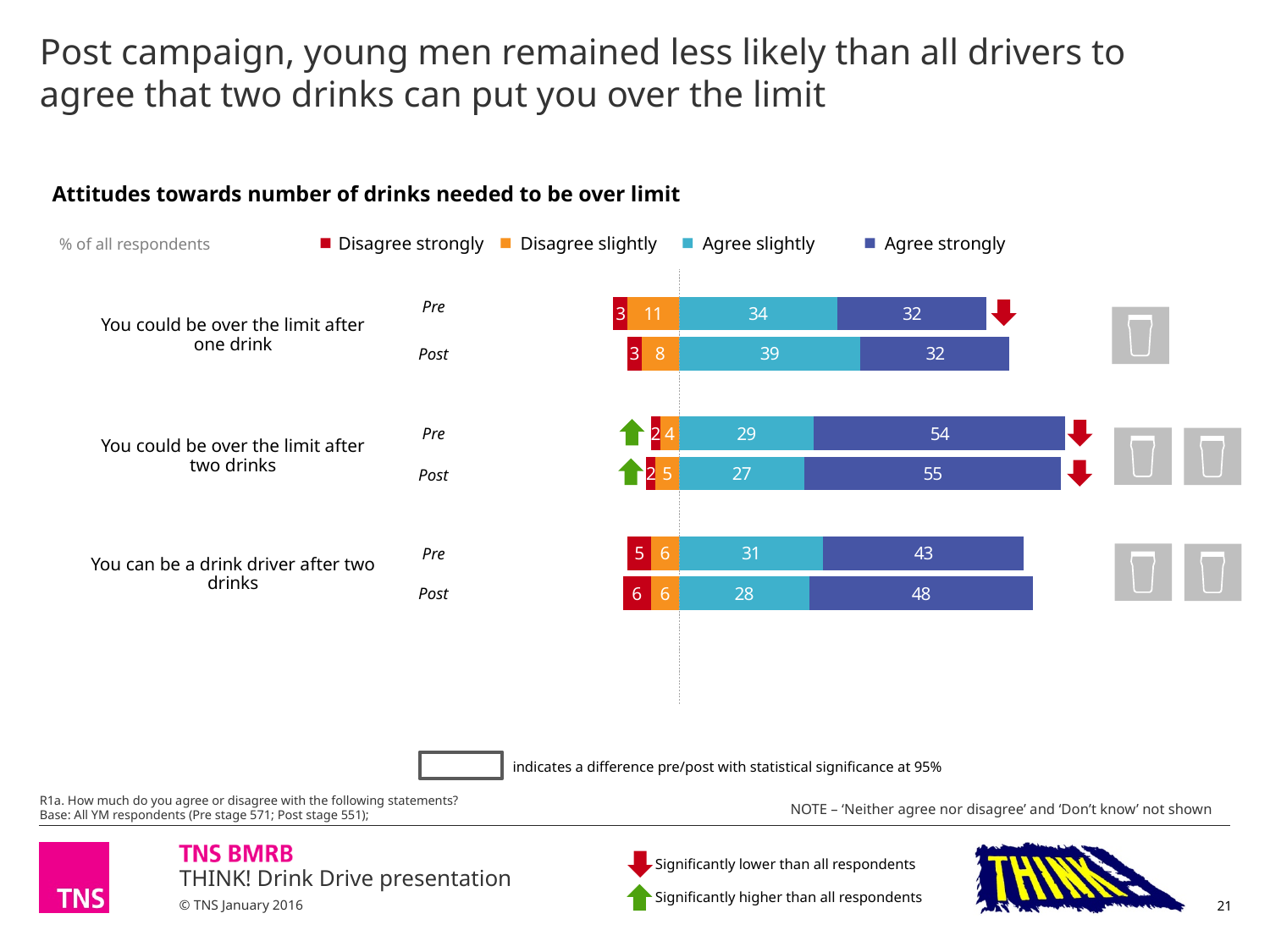
What is the 'Disagree slightly' value for the Post bar of 'You could be over the limit after one drink'? 8 What is the 'Disagree strongly' value for the Post bar of 'You can be a drink driver after two drinks'? 6 Which bar has the highest 'Agree strongly' value? You could be over the limit after two drinks, Post What is the 'Agree slightly' value for the Pre bar of 'You could be over the limit after one drink'? 34 What is the 'Agree strongly' value for the Post bar of 'You could be over the limit after two drinks'? 55 What is the difference in 'Agree strongly' between the Post and Pre bars of 'You can be a drink driver after two drinks'? 5 How many bars are plotted in the chart? 6 What type of chart is shown on the slide? Stacked bar chart What is the total of the four printed segments in the Pre bar of 'You could be over the limit after two drinks'? 89 How many series does the legend list? 4 Which is larger: the 'Agree slightly' value for the Pre bar or the Post bar of 'You could be over the limit after one drink'? Post What is the title of the chart? Attitudes towards number of drinks needed to be over limit